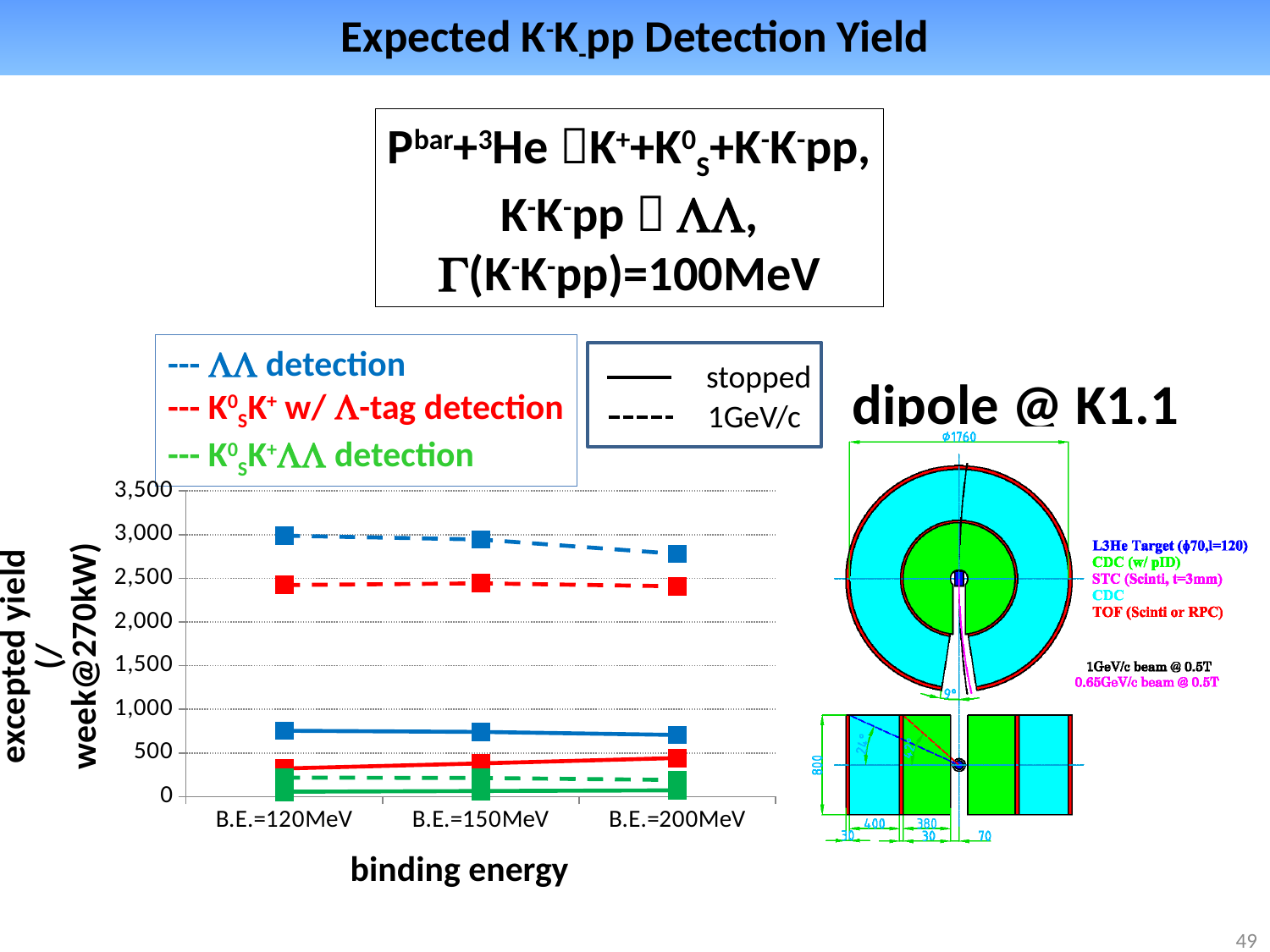
What kind of chart is shown on the slide? line chart At B.E.=120MeV, which is larger: the dashed blue (ΛΛ detection, 1GeV/c) value or the dashed red (K0sK+ w/ Λ-tag detection, 1GeV/c) value? dashed blue (ΛΛ detection, 1GeV/c) What is the title of the x axis of the chart? binding energy Is the value of the solid green (K0sK+ΛΛ detection, stopped) line at B.E.=120MeV greater or less than 500? less Is the value of the solid blue (ΛΛ detection, stopped) line at B.E.=120MeV greater or less than 500? greater Does the dashed blue (ΛΛ detection, 1GeV/c) line rise or fall from B.E.=120MeV to B.E.=200MeV? fall Which beam condition does the dashed line style represent in the chart legend? 1GeV/c Which line has the highest value at B.E.=120MeV? dashed blue (ΛΛ detection, 1GeV/c) Is the value of the dashed blue (ΛΛ detection, 1GeV/c) line at B.E.=120MeV greater or less than 2,500? greater How many binding energy categories are shown on the x axis of the chart? 3